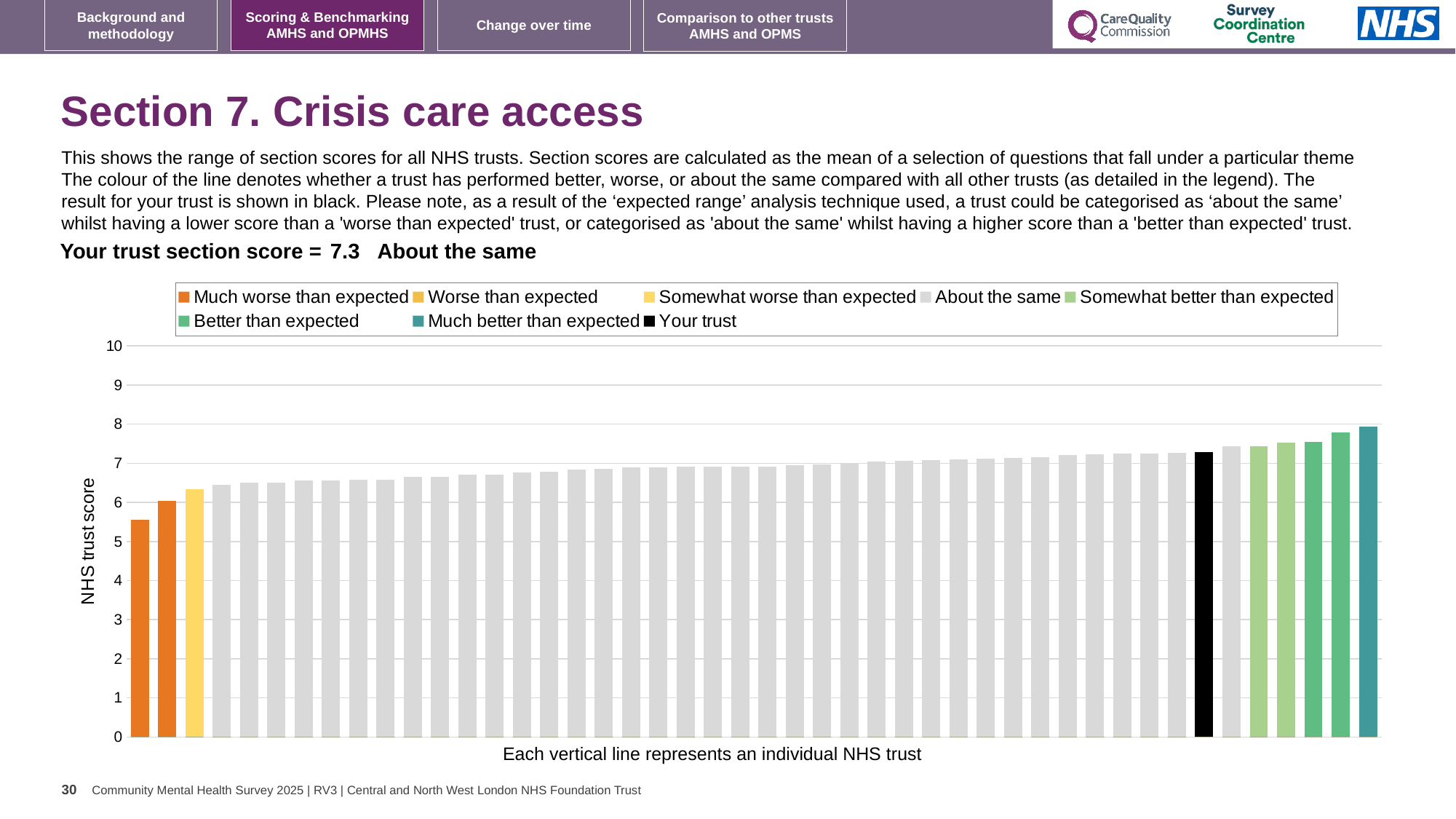
How many bars are coloured orange (Much worse than expected)? 2 What kind of chart is used to show the section scores for NHS trusts? bar chart What is the highest value shown on the vertical axis? 10 What is the section score for your trust shown on the slide? 7.3 What is the label on the vertical axis of the chart? NHS trust score Is the value of the leftmost (lowest) bar greater or less than 6? less How many entries does the chart legend list? 8 Which is larger: the black 'Your trust' bar or the leftmost orange bar? the black 'Your trust' bar Is the value of the black 'Your trust' bar greater or less than 7? greater Which benchmarking category is your trust placed in for this section? About the same Do the bar values rise or fall from left to right across the chart? rise